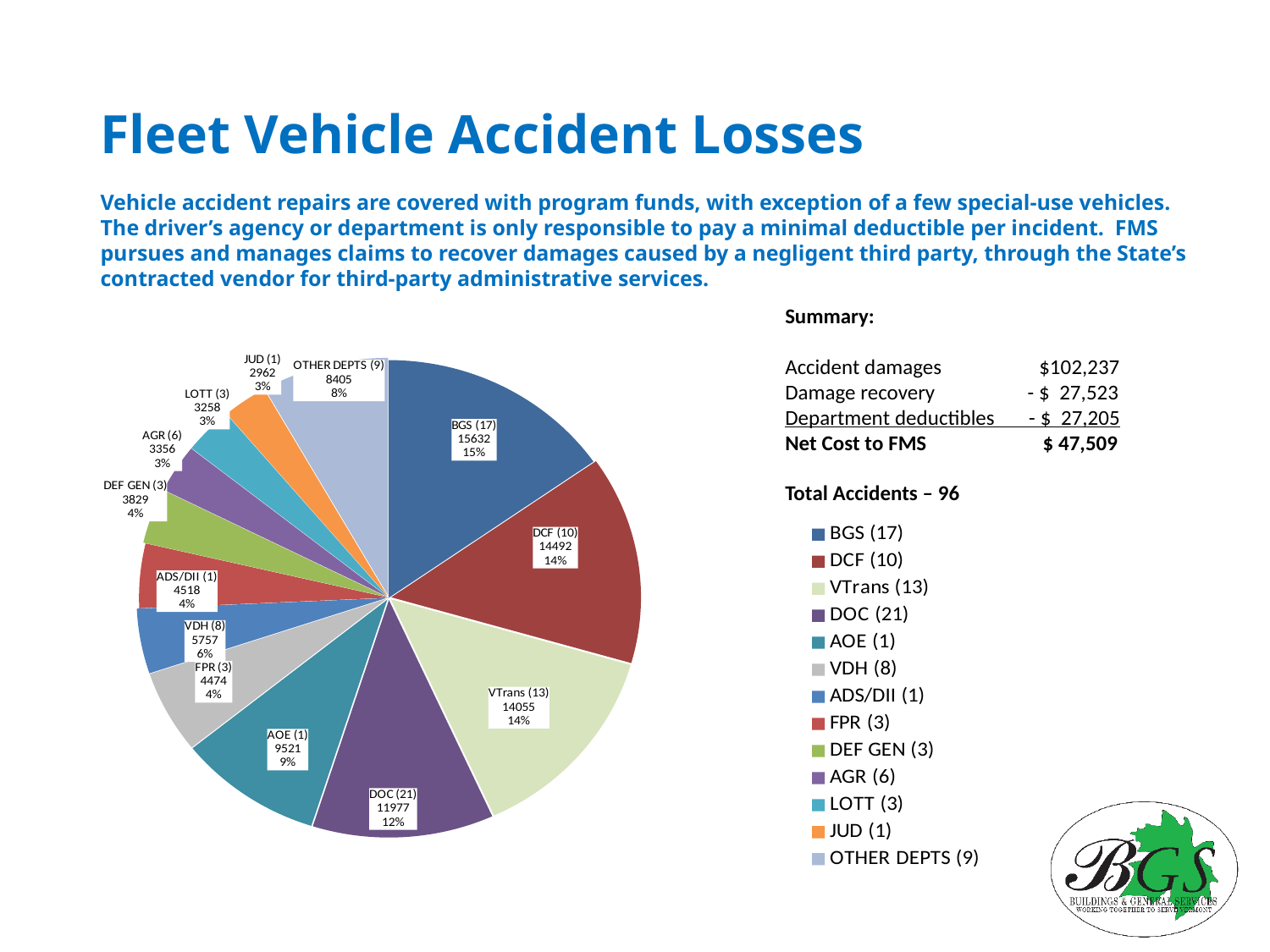
What is the value shown for BGS (17) in the pie chart? 15632 What type of chart is shown on the slide? Pie chart What is the value shown for DOC (21) in the pie chart? 11977 How many entries does the legend of the pie chart list? 13 What is the value shown for AOE (1) in the pie chart? 9521 What share of the pie does OTHER DEPTS (9) represent? 8% Which slice of the pie chart has the highest value? BGS (17) What share of the pie does VTrans (13) represent? 14% How many slices does the pie chart have? 13 What is the difference between the values for BGS (17) and DCF (10)? 1140 Which has a larger value, VDH (8) or ADS/DII (1)? VDH (8) Which slice of the pie chart has the lowest value? JUD (1)